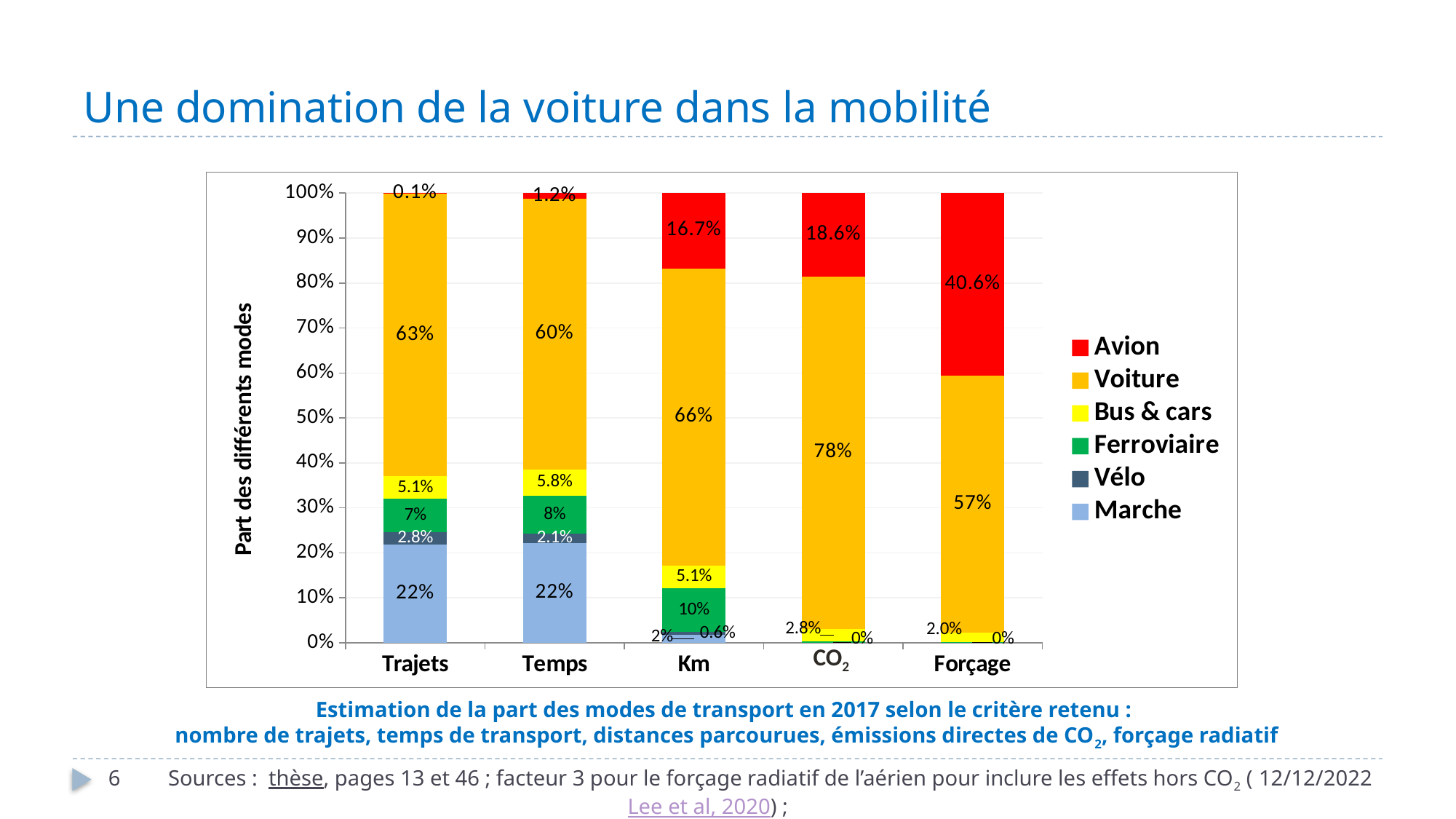
What is the share of Avion for the Forçage category? 40.6% What is the share of Voiture for the Trajets category? 63% What is the share of Avion for the CO2 category? 18.6% How many categories are shown on the x axis? 5 In which category is the Avion share the highest? Forçage What is the share of Ferroviaire for the Km category? 10% In which category is the Voiture share the highest? CO2 What type of chart is shown on the slide? stacked bar chart Which is larger: the Voiture share for Km or the Voiture share for Temps? Km What is the difference between the Avion share for Forçage and the Avion share for CO2? 22 percentage points How many series does the legend list? 6 What is the share of Marche for the Temps category? 22%